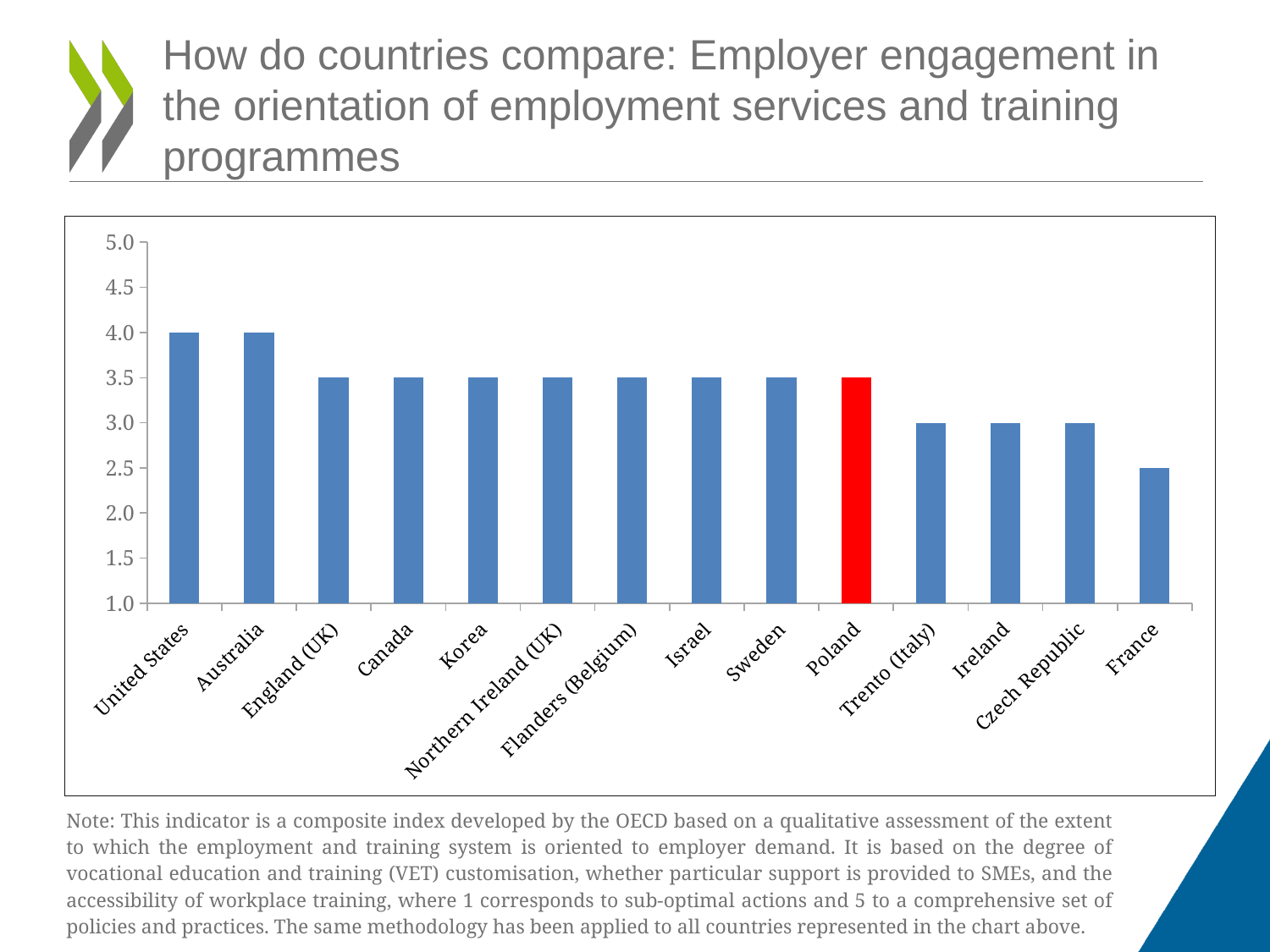
Do the values rise or fall from left to right along the x axis? fall What is the difference between the values for the United States and France? 1.5 Which has the larger value, Poland or Czech Republic? Poland What is the value for Ireland? 3.0 What kind of chart is shown on the slide? bar chart What is the value for Poland? 3.5 Which country's bar is coloured red? Poland What is the value for the United States? 4.0 How many countries or regions are shown in the chart? 14 What is the value for France? 2.5 Is the value for Trento (Italy) greater or less than 3.5? less Which country has the lowest value? France